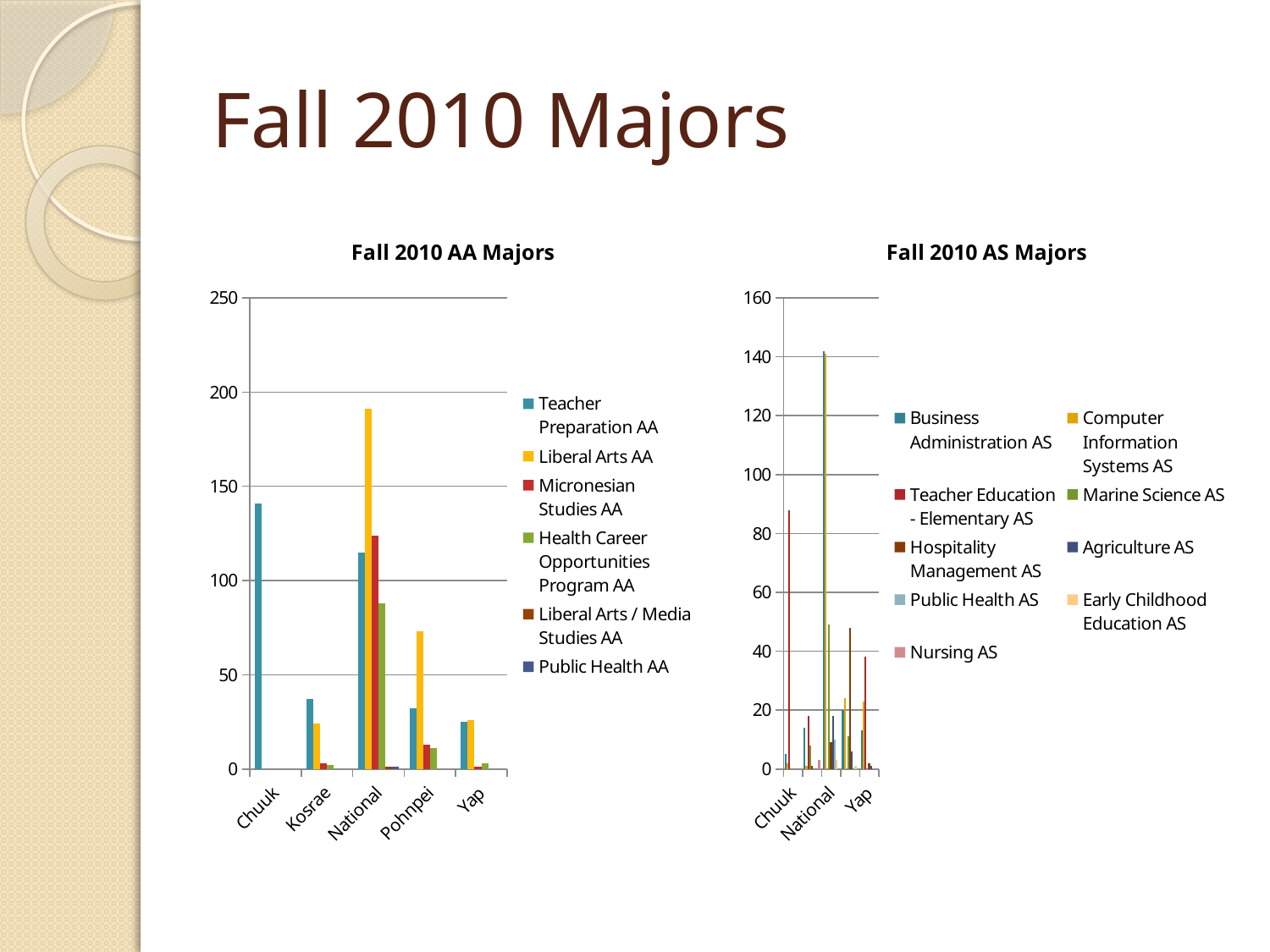
In the Fall 2010 AA Majors chart, is the Liberal Arts AA value for Pohnpei greater or less than 100? less What type of chart is the Fall 2010 AA Majors chart? bar chart In the Fall 2010 AS Majors chart, is the Teacher Education - Elementary AS value for Chuuk greater or less than 60? greater How many categories are shown on the x axis of the Fall 2010 AA Majors chart? 5 In the Fall 2010 AA Majors chart, which is larger for National: Liberal Arts AA or Micronesian Studies AA? Liberal Arts AA How many series does the legend of the Fall 2010 AS Majors chart list? 9 In the Fall 2010 AA Majors chart, which category has the highest Liberal Arts AA value? National In the Fall 2010 AA Majors chart, which category has the highest Teacher Preparation AA value? Chuuk In the Fall 2010 AA Majors chart, is the Liberal Arts AA value for National greater or less than 150? greater How many series does the legend of the Fall 2010 AA Majors chart list? 6 What is the title of the chart on the right side of the slide? Fall 2010 AS Majors